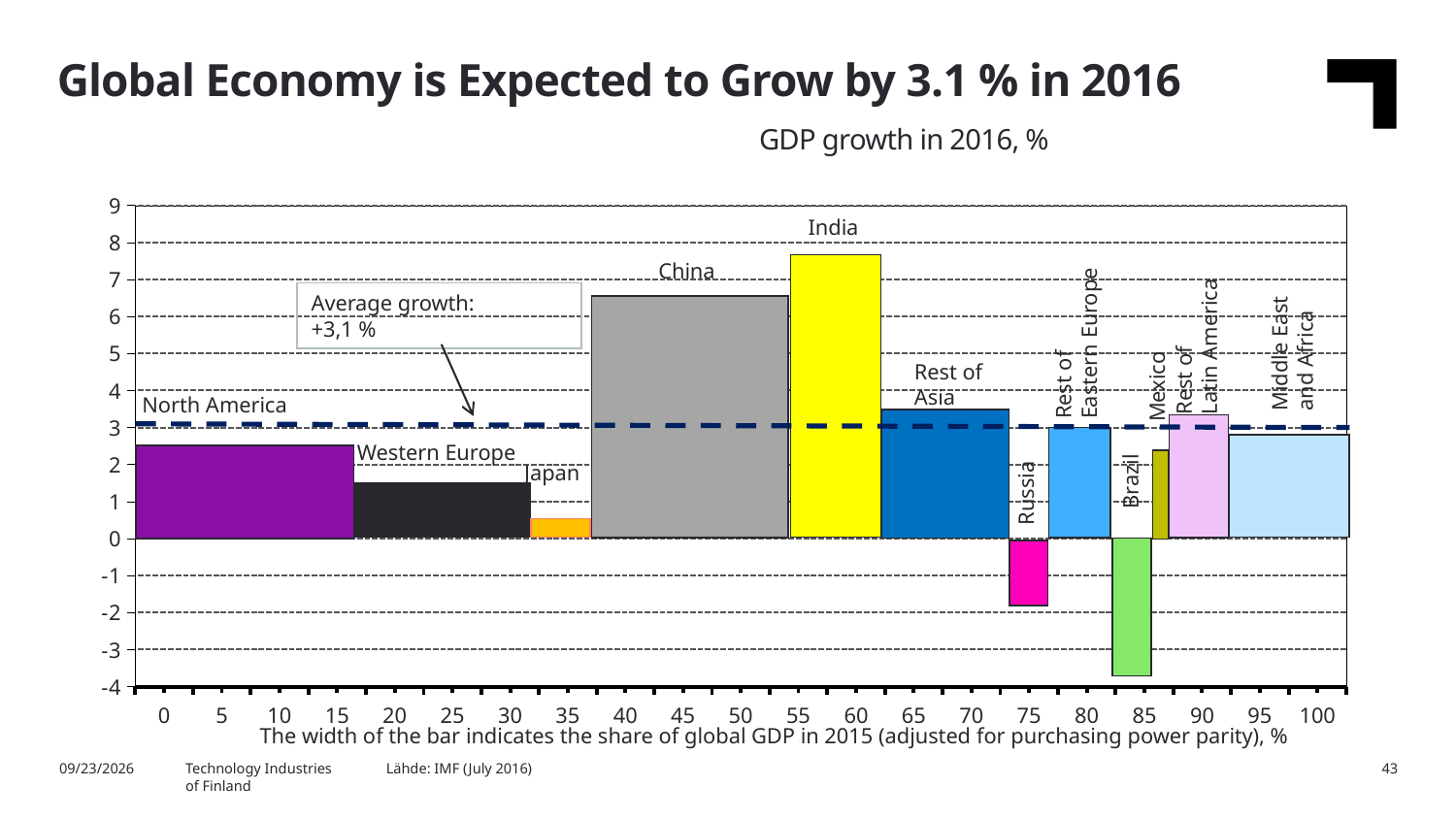
Is the value for Russia greater or less than -1? less Which has higher GDP growth in 2016, China or India? India Is the value for Japan greater or less than 1? less Is the value for Rest of Asia greater or less than 3? greater Which region has the highest GDP growth in 2016 on the chart? India How many regions show negative GDP growth in 2016 on the chart? 2 What kind of chart is shown on the slide? bar chart How many regions are shown as bars on the chart? 12 What average growth value is printed in the annotation box on the chart? +3,1 % Which region has the lowest GDP growth in 2016 on the chart? Brazil Which has higher GDP growth in 2016, North America or Western Europe? North America